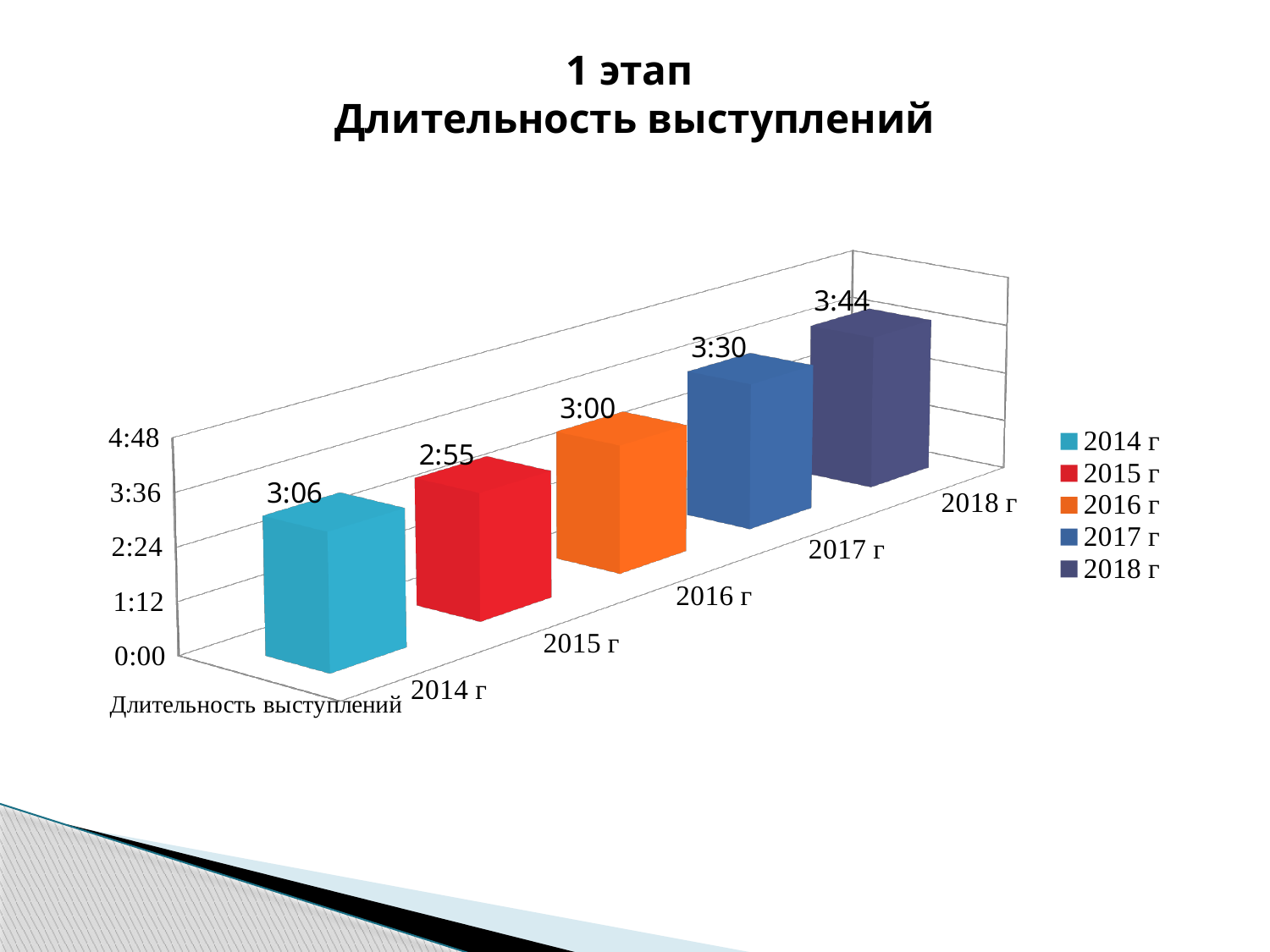
How many series does the legend list? 5 What kind of chart is shown on the slide? bar chart What is the value shown for 2014 г? 3:06 What is the value shown for 2015 г? 2:55 Which year has the highest value? 2018 г Do the values rise or fall from 2015 г to 2018 г? rise Is the value for 2018 г greater or less than 3:36? greater Which is larger, the value for 2017 г or the value for 2016 г? 2017 г Which year has the lowest value? 2015 г What is the value shown for 2016 г? 3:00 What is the value shown for 2018 г? 3:44 How many bars are plotted on the chart? 5